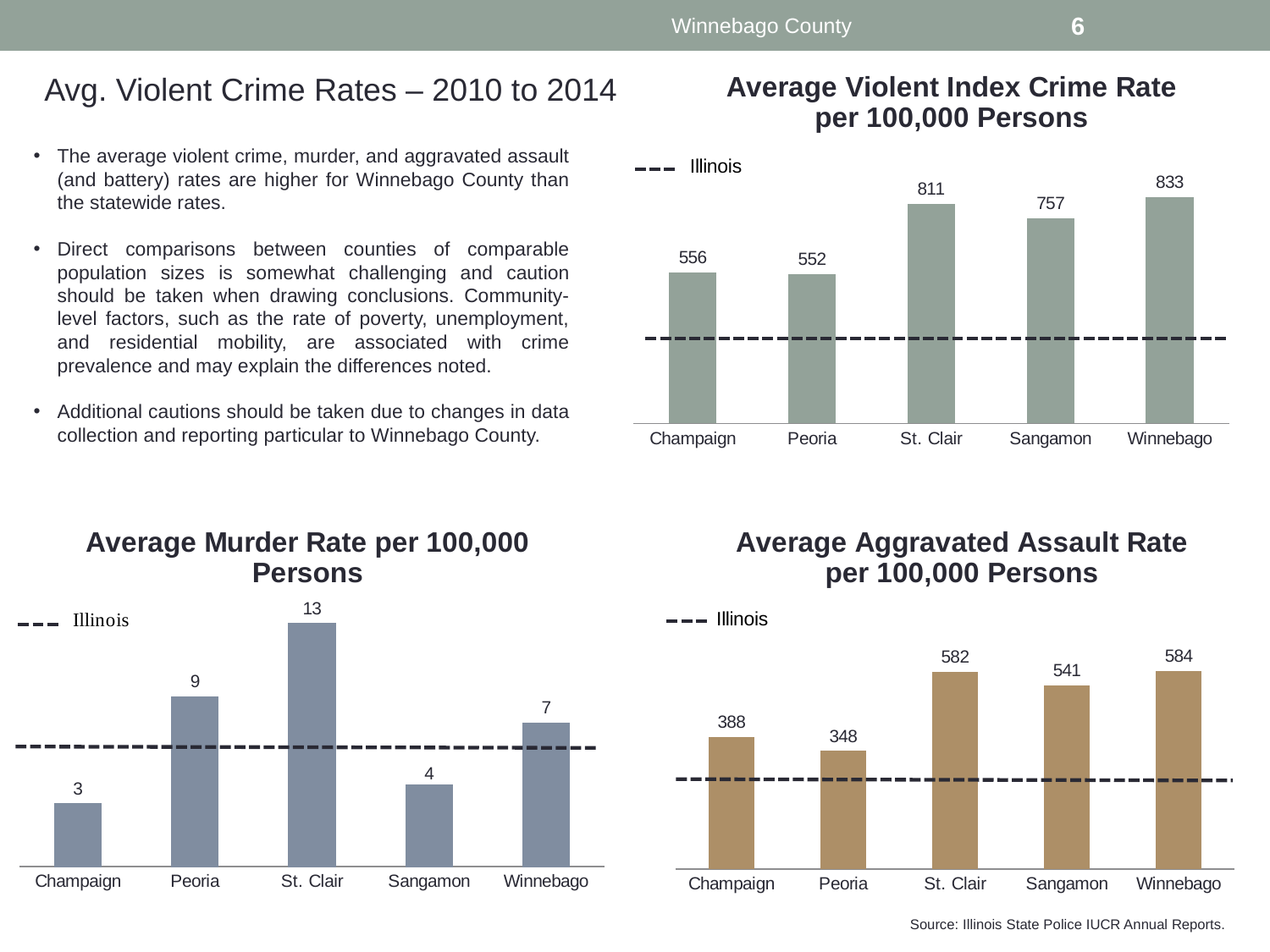
In the Average Murder Rate per 100,000 Persons chart, which county has the lowest rate? Champaign In the Average Violent Index Crime Rate per 100,000 Persons chart, what is the difference between Winnebago and Champaign? 277 In the Average Aggravated Assault Rate per 100,000 Persons chart, what is the difference between St. Clair and Champaign? 194 In the Average Murder Rate per 100,000 Persons chart, which is larger, Peoria or Sangamon? Peoria In the Average Violent Index Crime Rate per 100,000 Persons chart, how many counties are shown? 5 In the Average Aggravated Assault Rate per 100,000 Persons chart, what is the value for Sangamon? 541 What kind of chart is the Average Murder Rate per 100,000 Persons chart? Bar chart In the Average Violent Index Crime Rate per 100,000 Persons chart, what is the value for St. Clair? 811 In the Average Murder Rate per 100,000 Persons chart, which county has the highest rate? St. Clair In the Average Violent Index Crime Rate per 100,000 Persons chart, which county has the highest rate? Winnebago In the Average Murder Rate per 100,000 Persons chart, what is the value for Winnebago? 7 In the Average Aggravated Assault Rate per 100,000 Persons chart, which county has the lowest rate? Peoria